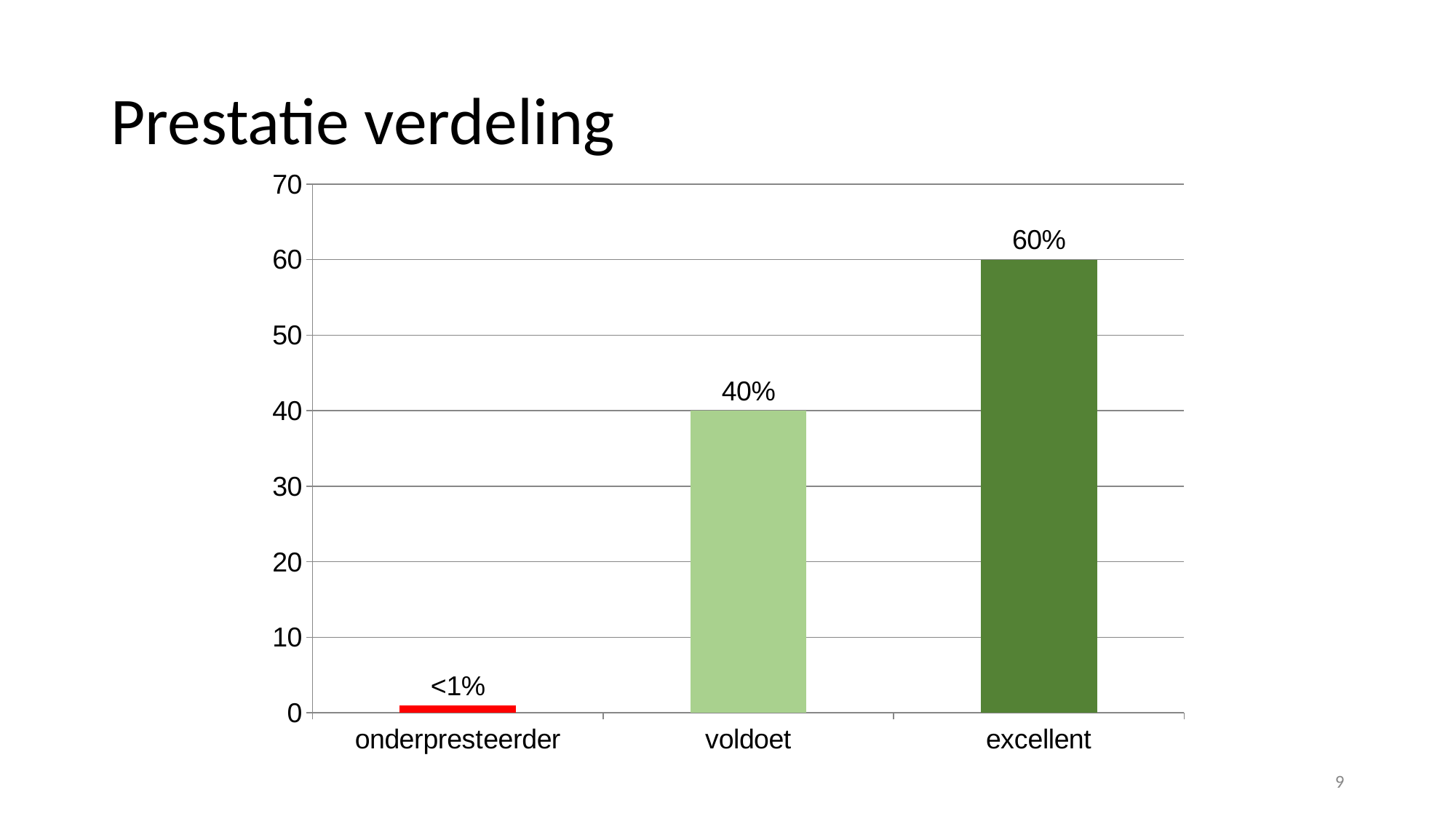
Is the value for onderpresteerder greater or less than 10? less What is the title of the slide? Prestatie verdeling How many categories are shown on the x axis? 3 What is the value for voldoet? 40% What is the data label shown for onderpresteerder? <1% Do the values rise or fall from left to right along the x axis? rise What is the difference between the values for excellent and voldoet? 20% Which is larger, the value for voldoet or the value for excellent? excellent Which category has the lowest value? onderpresteerder What kind of chart is shown on the slide? bar chart Which category has the highest value? excellent What is the value for excellent? 60%